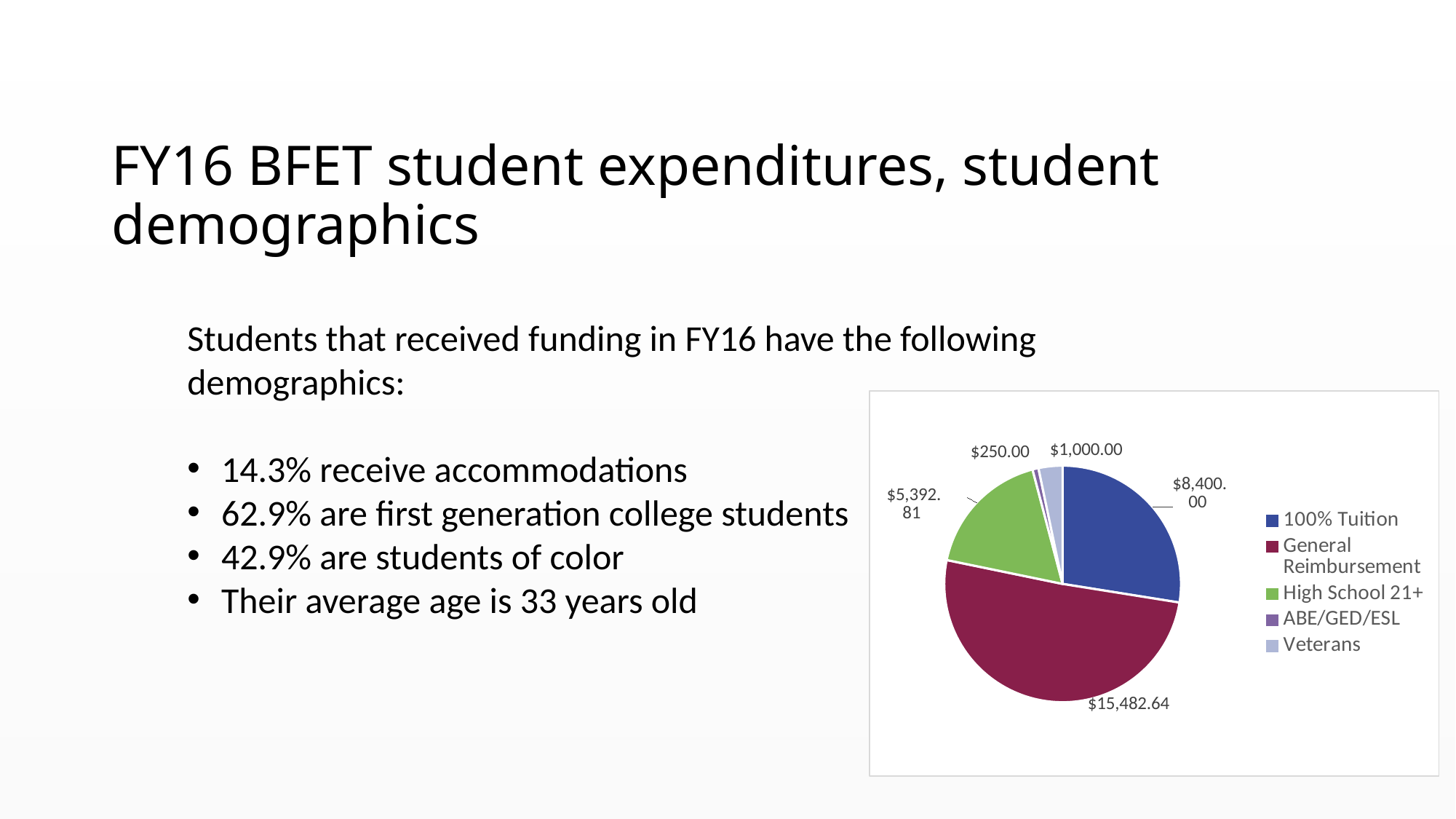
What is the value for 100% Tuition in the pie chart? $8,400.00 What is the value for General Reimbursement in the pie chart? $15,482.64 Which is larger, the value for 100% Tuition or the value for High School 21+? 100% Tuition What is the difference between the General Reimbursement and 100% Tuition values? $7,082.64 Which category has the largest slice in the pie chart? General Reimbursement What is the value for ABE/GED/ESL in the pie chart? $250.00 How many categories does the pie chart legend list? 5 Which category has the smallest slice in the pie chart? ABE/GED/ESL What is the value for High School 21+ in the pie chart? $5,392.81 What type of chart is shown on the slide? Pie chart What is the value for Veterans in the pie chart? $1,000.00 What colour is the General Reimbursement slice in the pie chart? Dark red